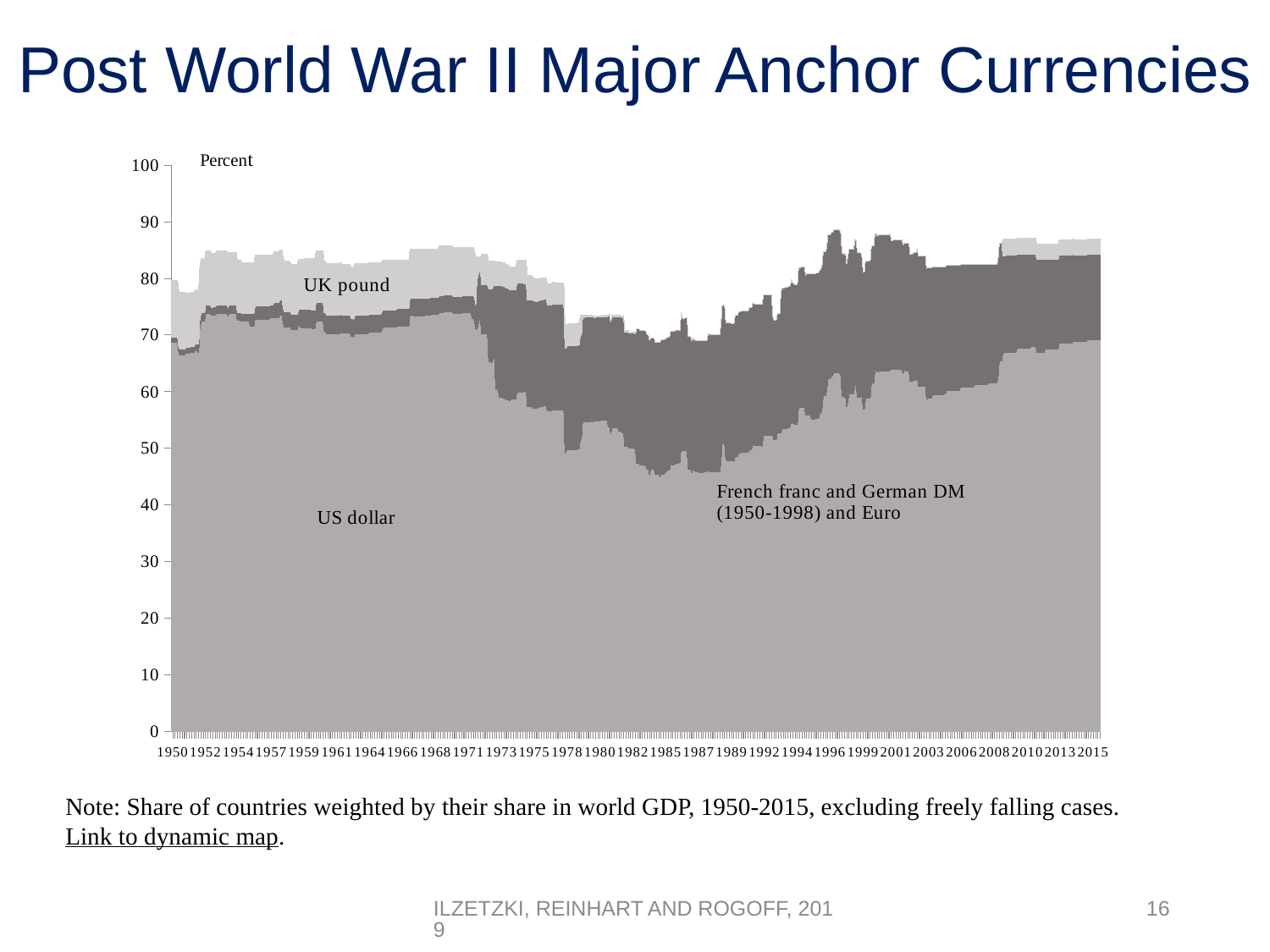
Is the US dollar share in 2015 greater or less than 60? greater Does the US dollar share rise or fall between 1971 and 1985? fall Which currency series occupies the largest share throughout the chart? US dollar Is the combined share of all three anchor currencies in 1985 greater or less than 80? less Is the US dollar share in 1985 greater or less than 50? less What is the title of the chart on the slide? Post World War II Major Anchor Currencies What unit label is shown at the top of the y axis? Percent What kind of chart is shown on the slide? Stacked area chart How many currency series are shown in the stacked area chart? 3 Does the US dollar share rise or fall overall between 1985 and 2015? rise Which is larger in 1960: the US dollar share or the UK pound share? US dollar